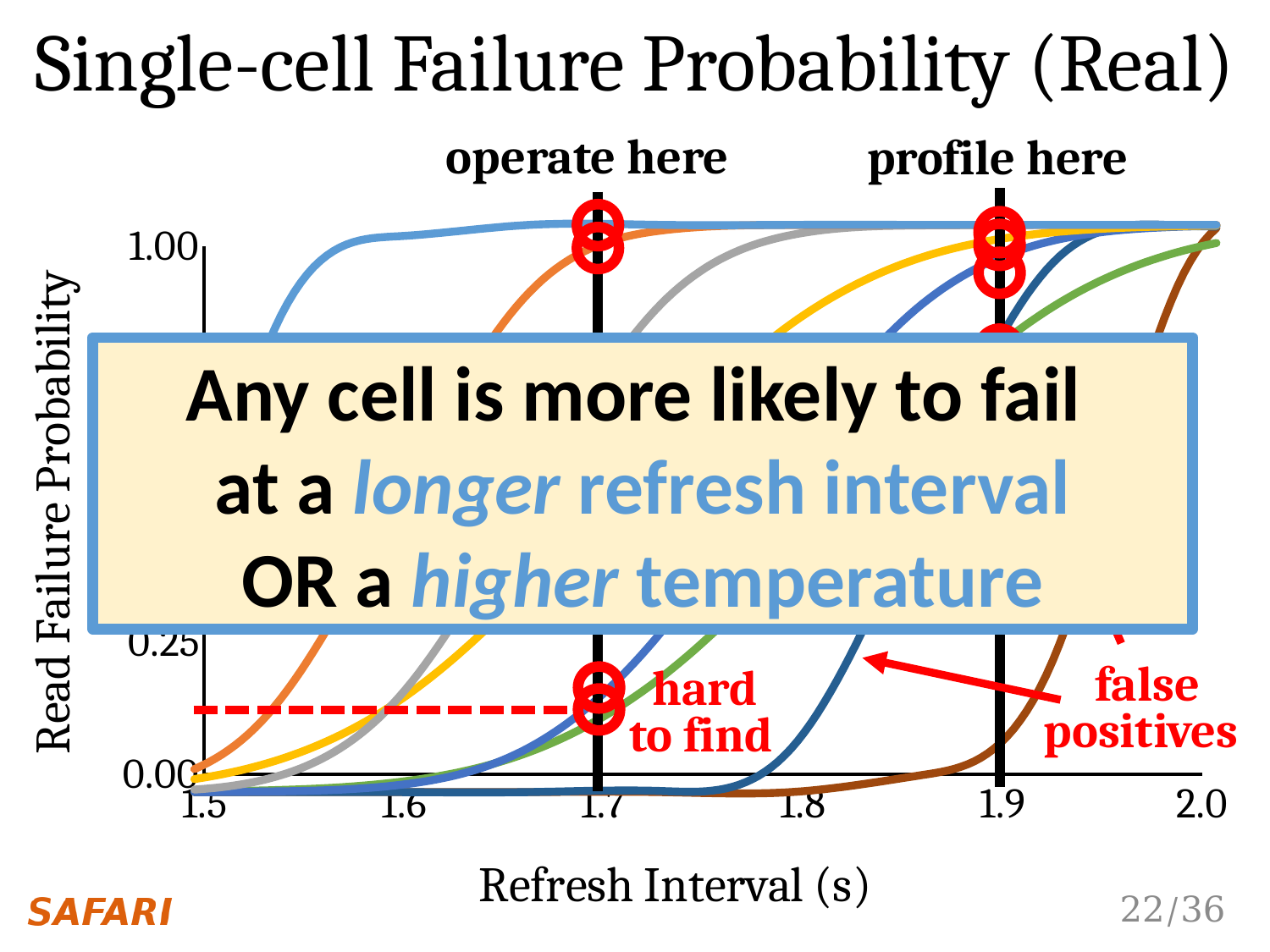
At which refresh interval is the vertical line annotated "profile here" drawn? 1.9 Which of the two annotated refresh intervals, "operate here" or "profile here", is the longer one? profile here How many tick values are labelled on the x axis of the chart? 6 What is the highest value labelled on the y axis of the chart? 1.00 What kind of chart is shown on the slide? line chart What is the label of the x axis of the chart? Refresh Interval (s) What is the smallest refresh interval labelled on the x axis? 1.5 What is the largest refresh interval labelled on the x axis? 2.0 At which refresh interval is the vertical line annotated "operate here" drawn? 1.7 What is the title of the chart on the slide? Single-cell Failure Probability (Real) As the refresh interval increases along the x axis, do the plotted curves rise or fall? rise